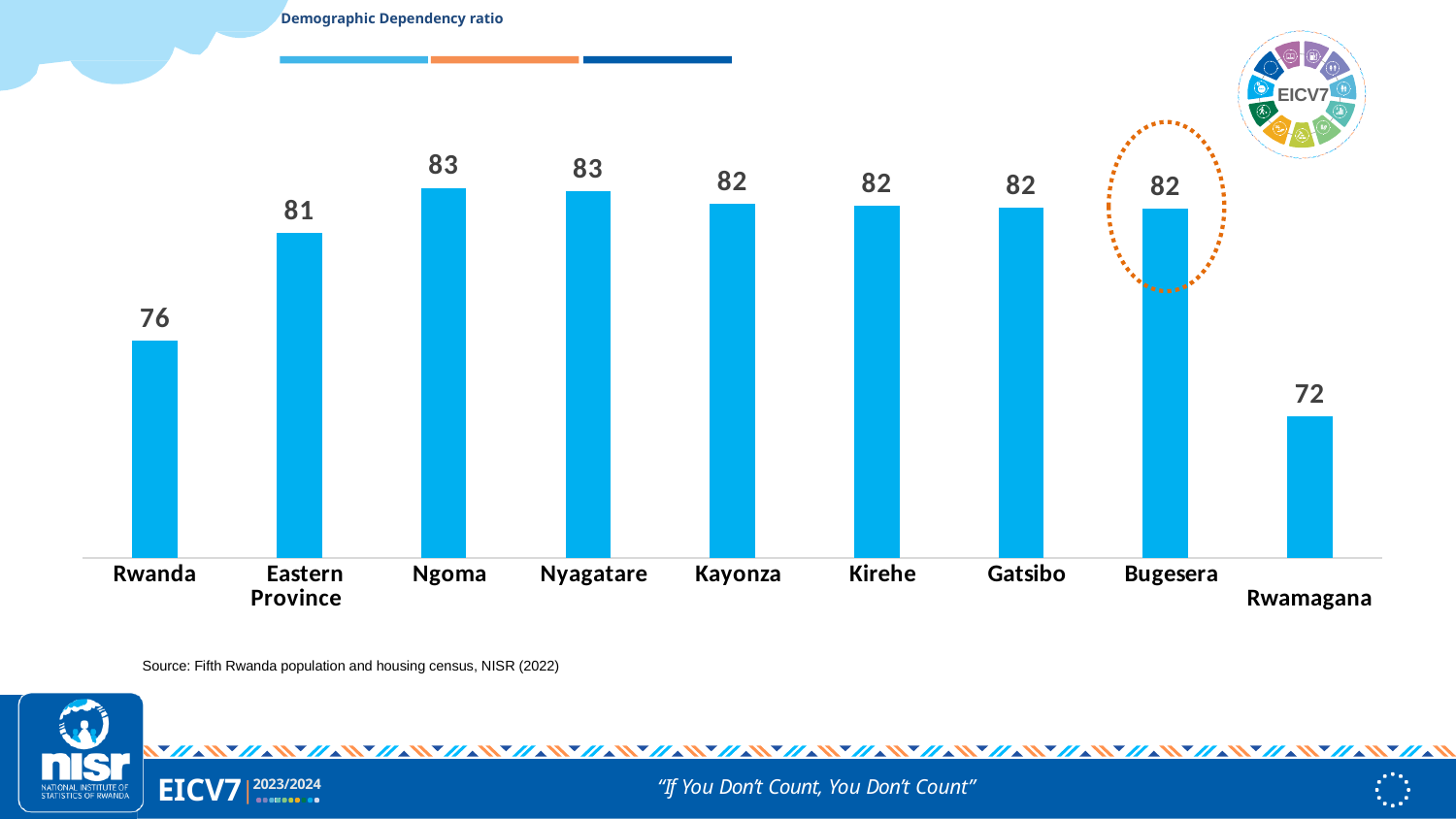
What is the demographic dependency ratio for Rwamagana? 72 What is the demographic dependency ratio for Bugesera? 82 What kind of chart is shown on the slide? Bar chart What is the title of the chart? Demographic Dependency ratio Which has a higher demographic dependency ratio, Kirehe or Rwamagana? Kirehe What is the demographic dependency ratio for Rwanda? 76 How many categories are shown on the chart? 9 Which category has the lowest demographic dependency ratio? Rwamagana Which has a higher demographic dependency ratio, Ngoma or Rwanda? Ngoma What is the difference between the demographic dependency ratio of Eastern Province and Rwanda? 5 What is the difference between the demographic dependency ratio of Ngoma and Rwamagana? 11 What is the demographic dependency ratio for Eastern Province? 81